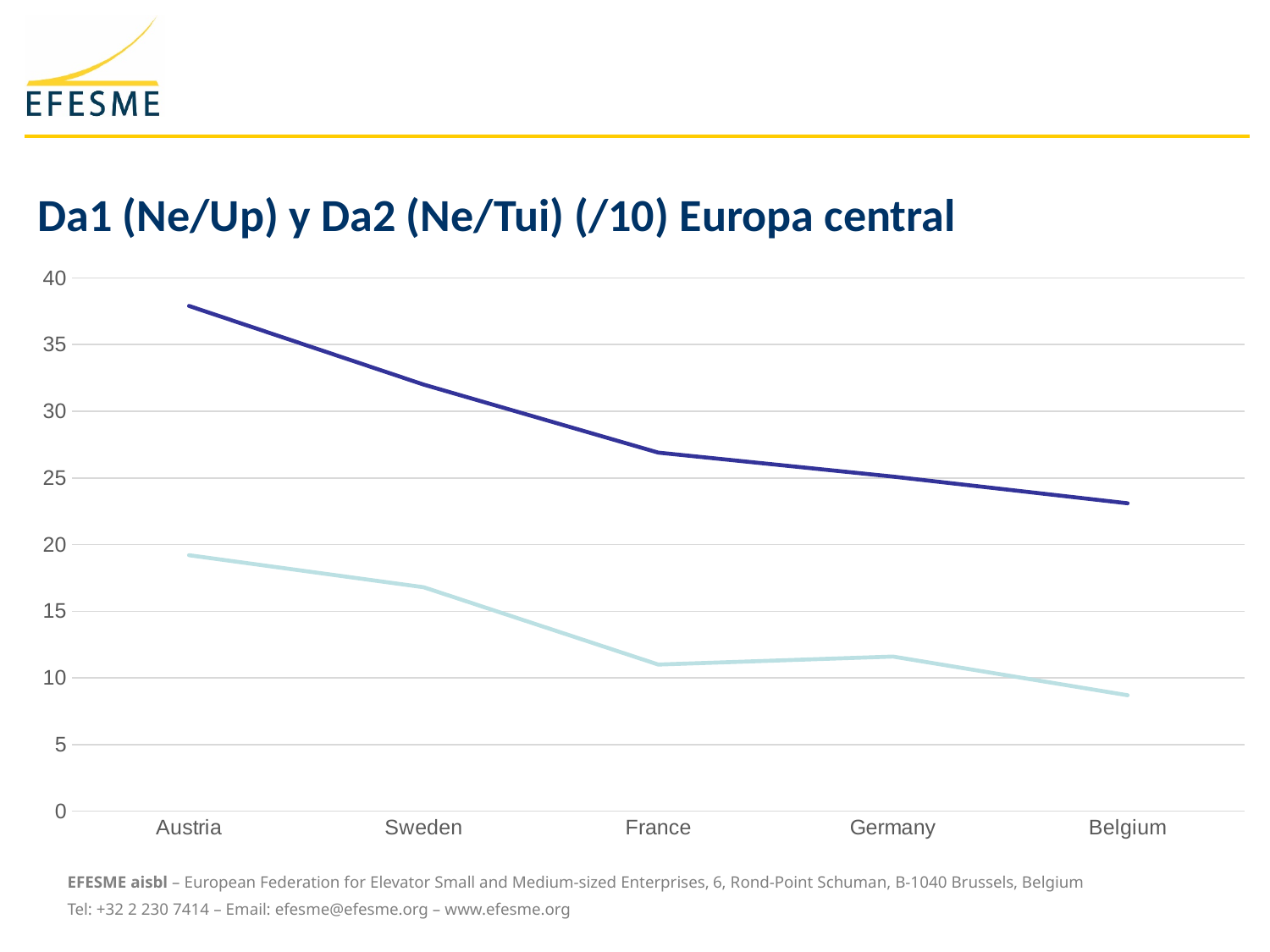
Is the dark blue line's value for Austria greater or less than 35? greater Is the light blue line's value for Belgium greater or less than 10? less Which country has the highest value on the dark blue line? Austria What kind of chart is shown on the slide? line chart How many countries are shown on the x axis of the chart? 5 Does the dark blue line rise or fall from Austria to Belgium? fall What is the title of the chart? Da1 (Ne/Up) y Da2 (Ne/Tui) (/10) Europa central How many lines are plotted on the chart? 2 For France, which line has the larger value, the dark blue line or the light blue line? the dark blue line Is the dark blue line's value for Belgium greater or less than 25? less Which country has the lowest value on the light blue line? Belgium Which country has the lowest value on the dark blue line? Belgium